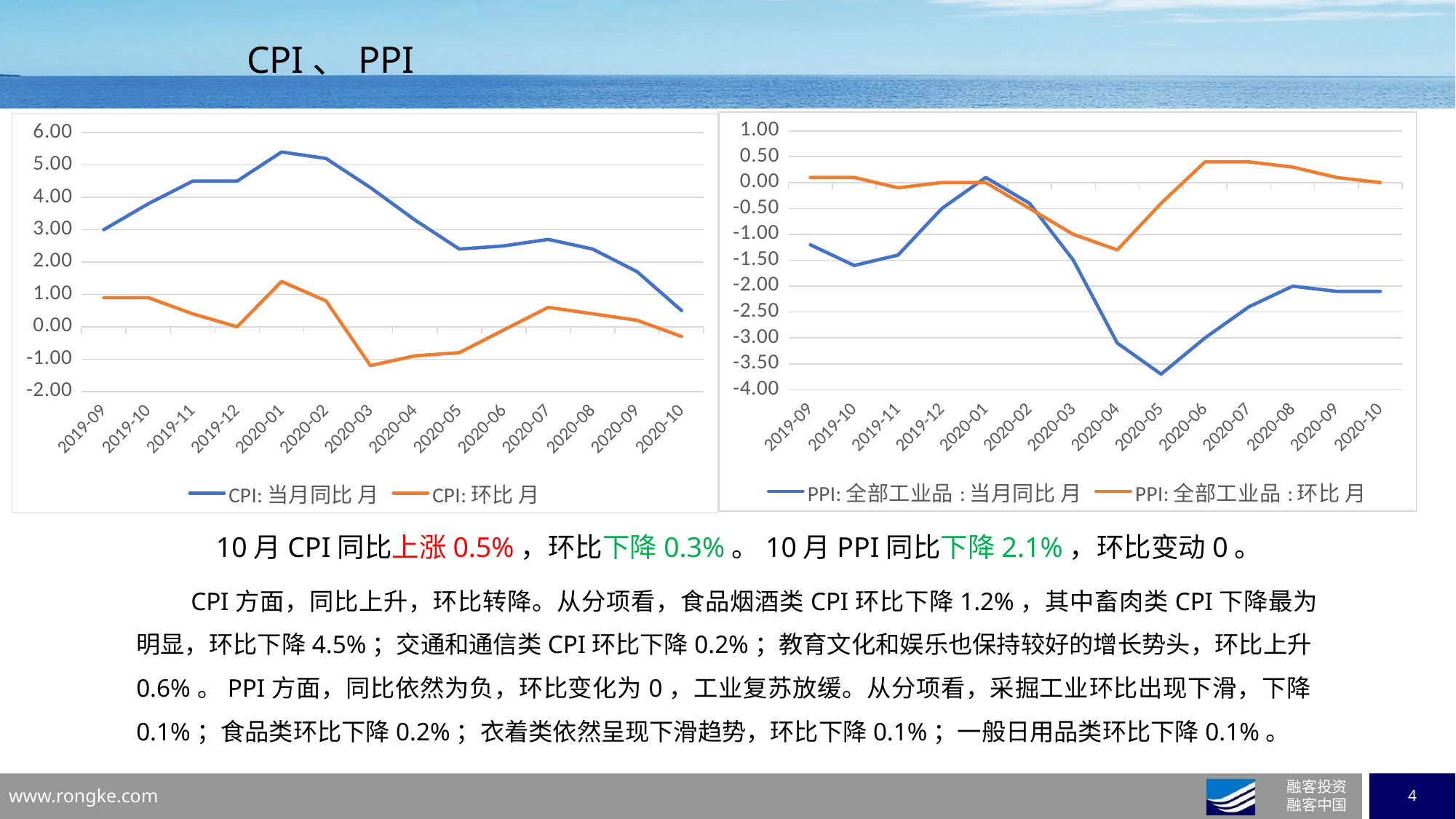
How many series does the legend of the right chart (PPI) list? 2 How many months are plotted along the x axis of the right chart (PPI)? 14 In the left chart (CPI), in which month does the CPI: 当月同比 月 series reach its highest value? 2020-01 In the right chart (PPI), in which month does the PPI: 全部工业品:当月同比 月 series reach its lowest value? 2020-05 How many series does the legend of the left chart (CPI) list? 2 In the right chart (PPI), which series has the higher value in 2020-06, PPI: 全部工业品:当月同比 月 or PPI: 全部工业品:环比 月? PPI: 全部工业品:环比 月 In the left chart (CPI), which series has the higher value in 2019-09, CPI: 当月同比 月 or CPI: 环比 月? CPI: 当月同比 月 In the right chart (PPI), is the value of PPI: 全部工业品:当月同比 月 for 2020-05 greater or less than -3.50? less What kind of chart is the left chart (CPI)? line chart In the left chart (CPI), does the CPI: 当月同比 月 series rise or fall from 2020-01 to 2020-10? fall In the left chart (CPI), is the value of CPI: 环比 月 for 2020-03 greater or less than -1.00? less In the left chart (CPI), is the value of CPI: 当月同比 月 for 2020-01 greater or less than 5.00? greater